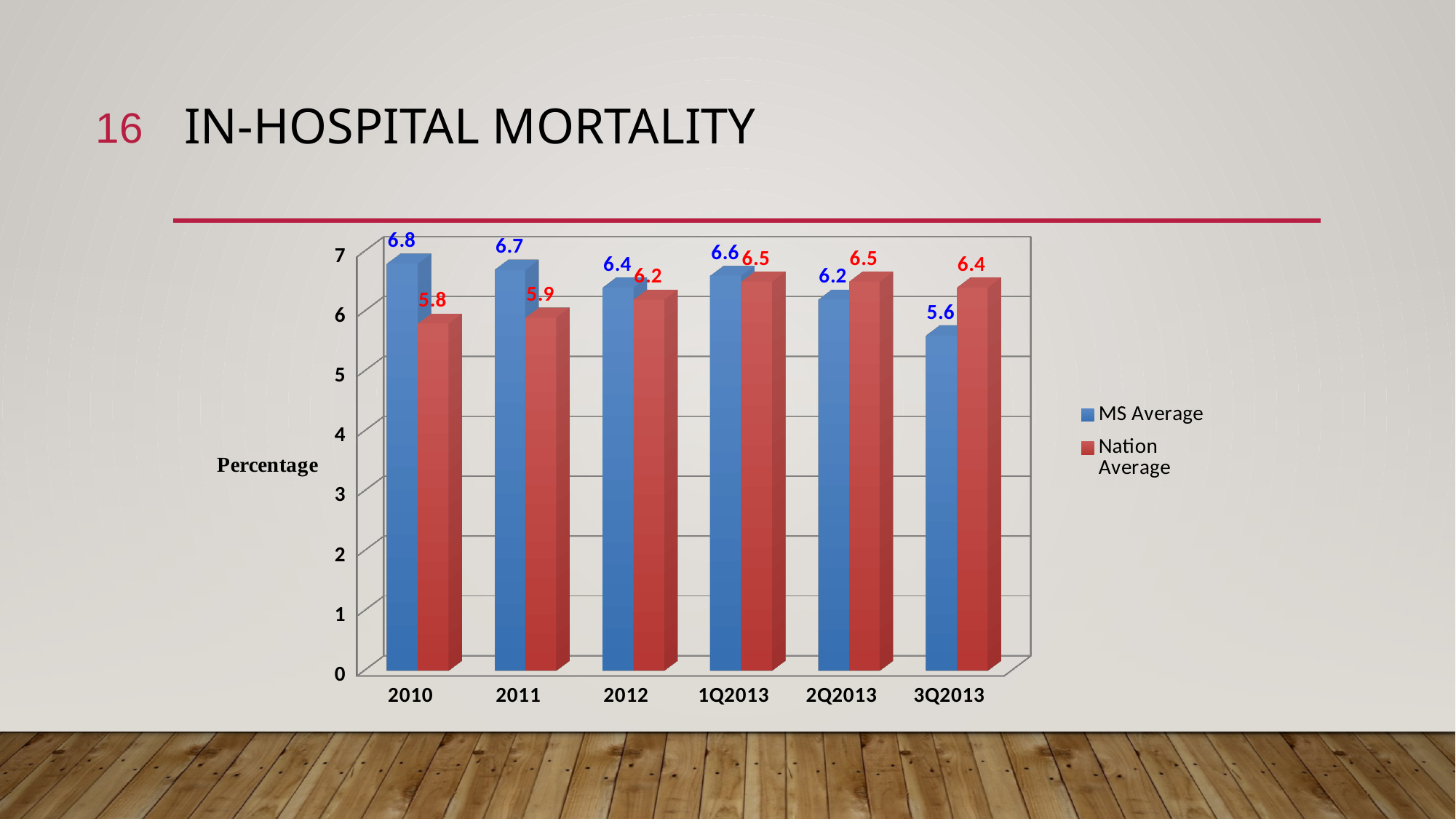
Which category has the lowest Nation Average value? 2010 In 2011, which is larger, the MS Average or the Nation Average? MS Average How many series does the legend list? 2 Which category has the lowest MS Average value? 3Q2013 What is the difference between the MS Average and the Nation Average in 2010? 1.0 What is the MS Average value for 2010? 6.8 How many categories are shown on the x axis? 6 Does the MS Average rise or fall from 2010 to 3Q2013? Fall What is the MS Average value for 2Q2013? 6.2 In 3Q2013, which is larger, the MS Average or the Nation Average? Nation Average What is the Nation Average value for 3Q2013? 6.4 What kind of chart is shown on the slide? Bar chart